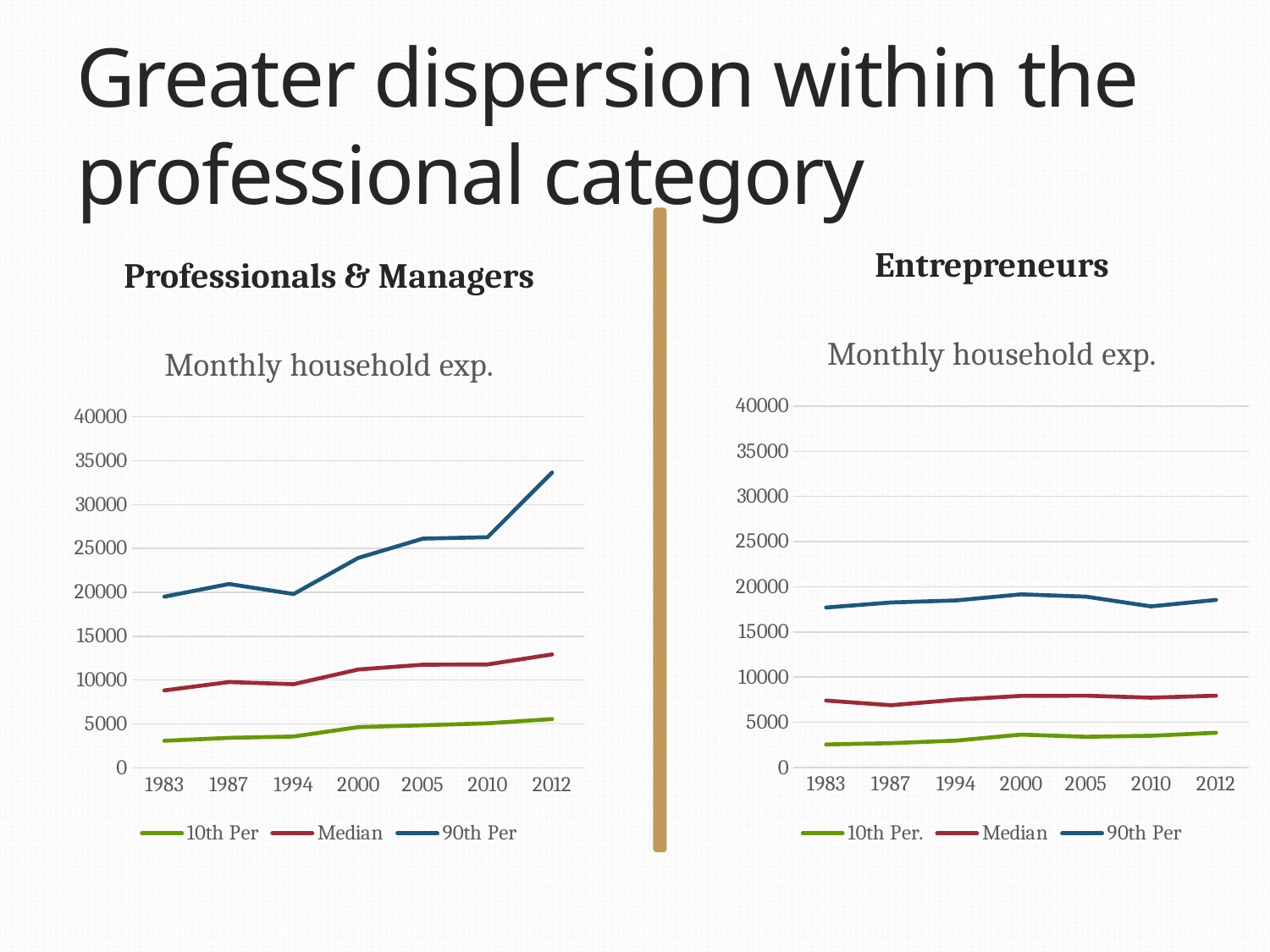
In the Entrepreneurs chart, is the 90th Per value for 2012 greater or less than 20000? less In the Professionals & Managers chart, is the 90th Per value for 2012 greater or less than 30000? greater Which is larger: the 90th Per value for 2012 in the Professionals & Managers chart or the 90th Per value for 2012 in the Entrepreneurs chart? Professionals & Managers What is the title of the Entrepreneurs chart? Monthly household exp. How many series does the legend of the Entrepreneurs chart list? 3 In the Entrepreneurs chart, is the Median value for 2012 greater or less than 10000? less What kind of chart is the Professionals & Managers chart? line chart In the Entrepreneurs chart, which series has the lowest values across all years? 10th Per. How many years are shown on the x axis of the Professionals & Managers chart? 7 In the Professionals & Managers chart, does the 90th Per series generally rise or fall from 1983 to 2012? rise